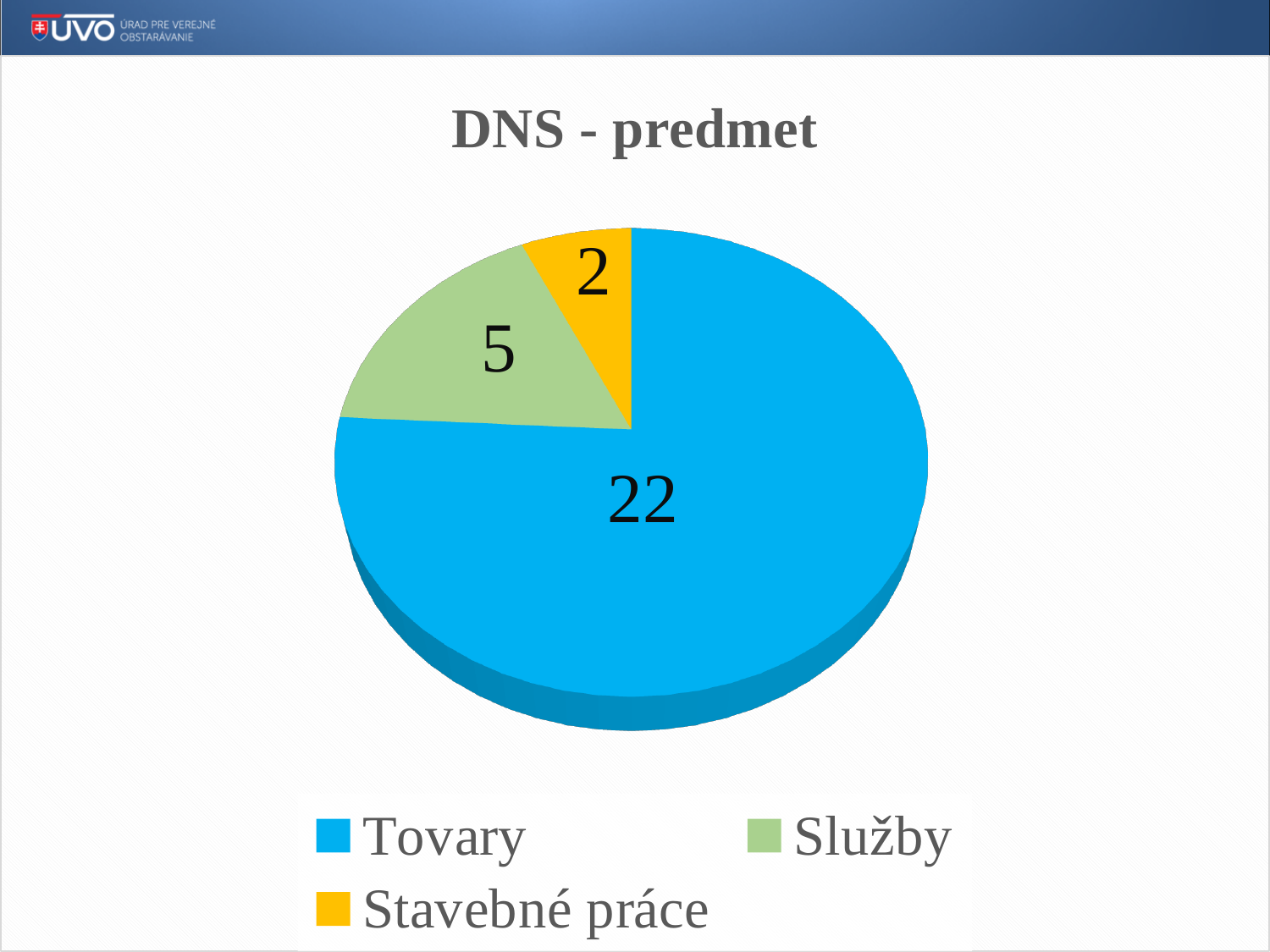
What is the total of all slices in the pie chart? 29 Which category has the largest slice? Tovary What is the title of the chart? DNS - predmet Which is larger, the value for Služby or the value for Stavebné práce? Služby Which category has the smallest slice? Stavebné práce What kind of chart is shown on the slide? pie chart What is the value for Stavebné práce? 2 What is the difference between the values for Služby and Stavebné práce? 3 How many categories does the pie chart show? 3 What is the value for Tovary? 22 What is the difference between the values for Tovary and Služby? 17 What is the value for Služby? 5